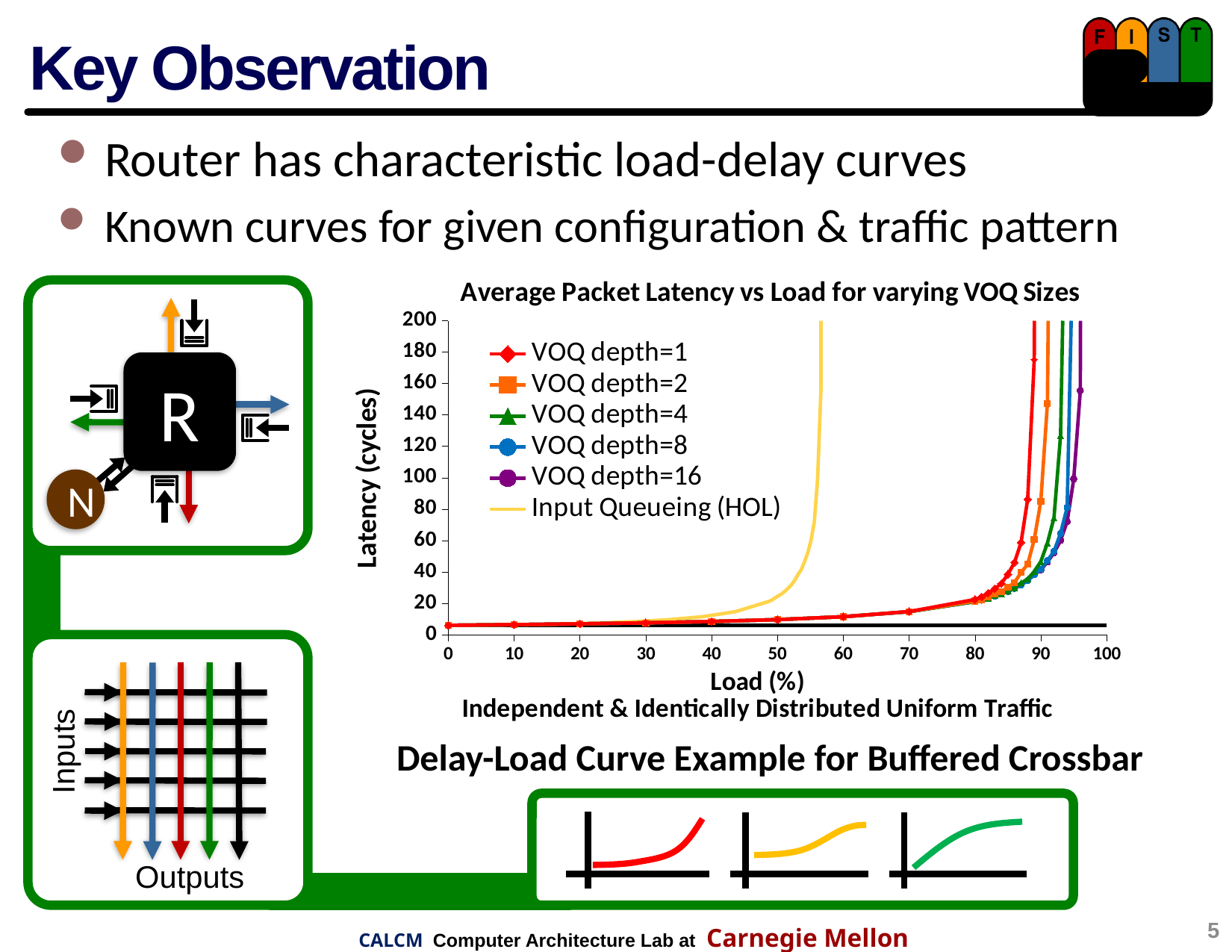
What is the title of the chart? Average Packet Latency vs Load for varying VOQ Sizes What kind of chart is shown on the slide? line chart Is the latency for VOQ depth=1 at a load of 70% greater or less than 40 cycles? less Is the latency for Input Queueing (HOL) at a load of 55% greater or less than 40 cycles? greater Which series reaches a latency of 200 cycles at the lowest load? Input Queueing (HOL) Which series reaches a latency of 200 cycles at the highest load? VOQ depth=16 How many series does the chart legend list? 6 Do the latency values rise or fall as load increases along the x axis? rise What is the label of the y axis of the chart? Latency (cycles) Is the latency for Input Queueing (HOL) at a load of 40% greater or less than 40 cycles? less What is the highest value shown on the y axis of the chart? 200 At a load of 50%, which series has the higher latency: Input Queueing (HOL) or VOQ depth=1? Input Queueing (HOL)